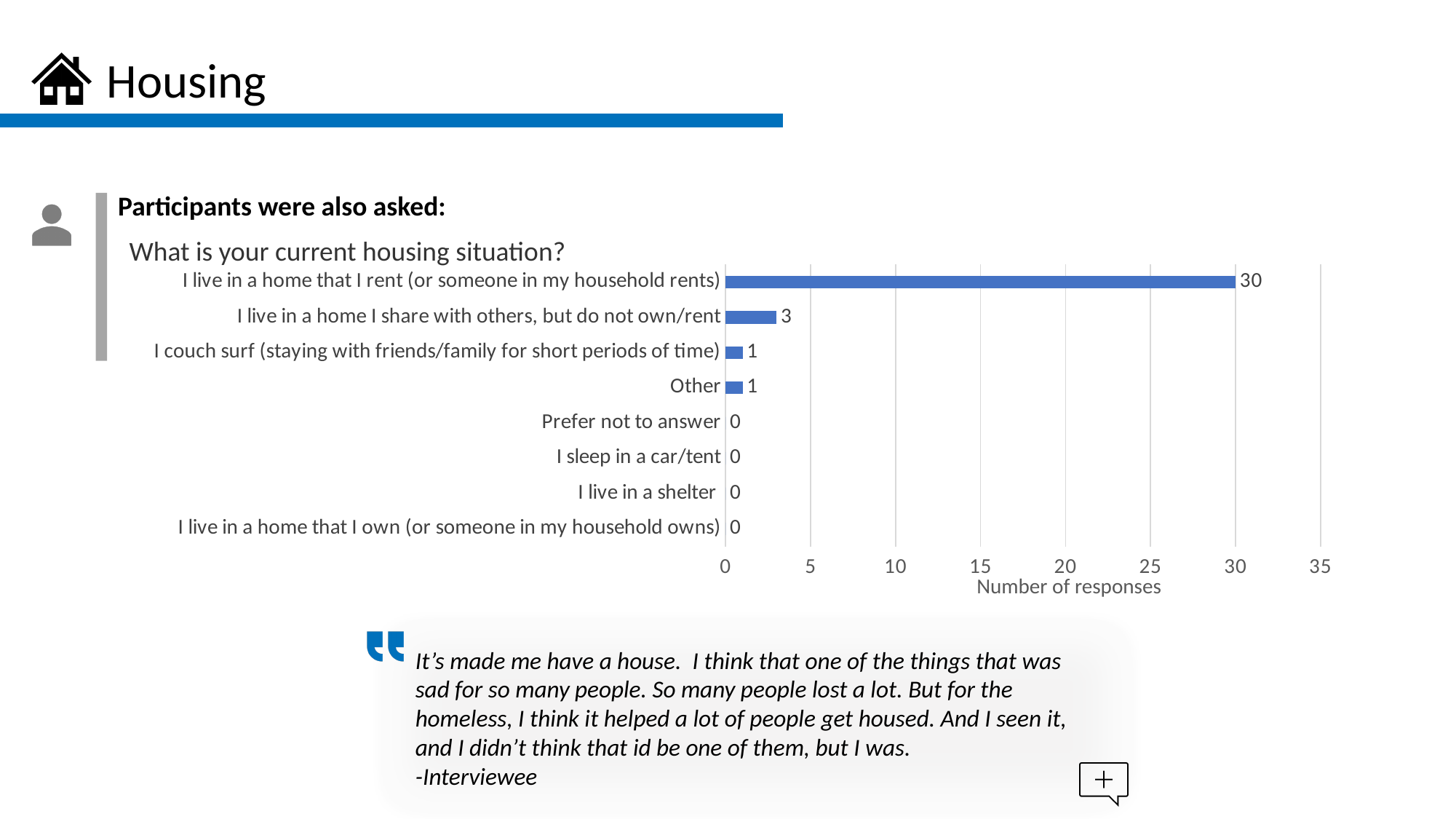
What is the difference in responses between "I live in a home that I rent (or someone in my household rents)" and "I live in a home I share with others, but do not own/rent"? 27 How many responses are shown for "I live in a home I share with others, but do not own/rent"? 3 How many categories have 0 responses? 4 Is the value for "I live in a home that I rent (or someone in my household rents)" greater or less than 25? greater Which has more responses: "I live in a home I share with others, but do not own/rent" or "Other"? I live in a home I share with others, but do not own/rent How many responses are shown for "I live in a home that I rent (or someone in my household rents)"? 30 How many housing situation categories are listed in the chart? 8 How many responses are shown for "I live in a shelter"? 0 How many responses are shown for "I couch surf (staying with friends/family for short periods of time)"? 1 What kind of chart is used to show the housing situation responses? Bar chart Which housing situation received the most responses? I live in a home that I rent (or someone in my household rents) What is the label of the horizontal axis of the chart? Number of responses